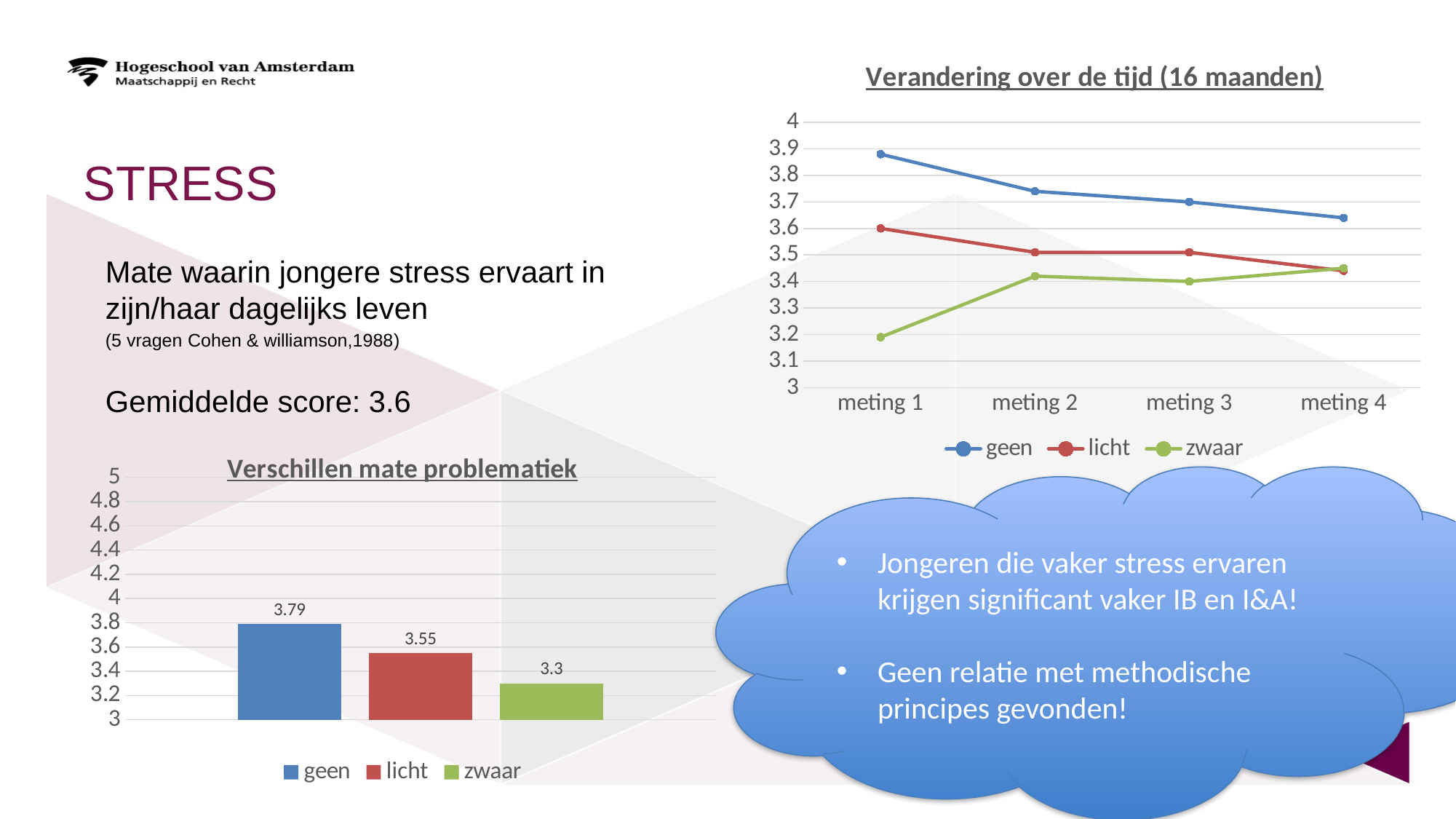
In the 'Verandering over de tijd (16 maanden)' chart, which series has the lowest value at meting 1? zwaar In the 'Verschillen mate problematiek' chart, what is the value for geen? 3.79 In the 'Verschillen mate problematiek' chart, what is the value for licht? 3.55 How many measurement points are shown on the x axis of the 'Verandering over de tijd (16 maanden)' chart? 4 How many series does the legend of the 'Verandering over de tijd (16 maanden)' chart list? 3 In the 'Verschillen mate problematiek' chart, which category has the highest value? geen In the 'Verschillen mate problematiek' chart, which category has the lowest value? zwaar In the 'Verschillen mate problematiek' chart, what is the value for zwaar? 3.3 What kind of chart is 'Verschillen mate problematiek'? bar chart In the 'Verschillen mate problematiek' chart, what is the difference between the values for geen and zwaar? 0.49 In the 'Verandering over de tijd (16 maanden)' chart, is the value for geen at meting 1 greater or less than 3.8? greater In the 'Verandering over de tijd (16 maanden)' chart, does the geen line rise or fall from meting 1 to meting 4? fall